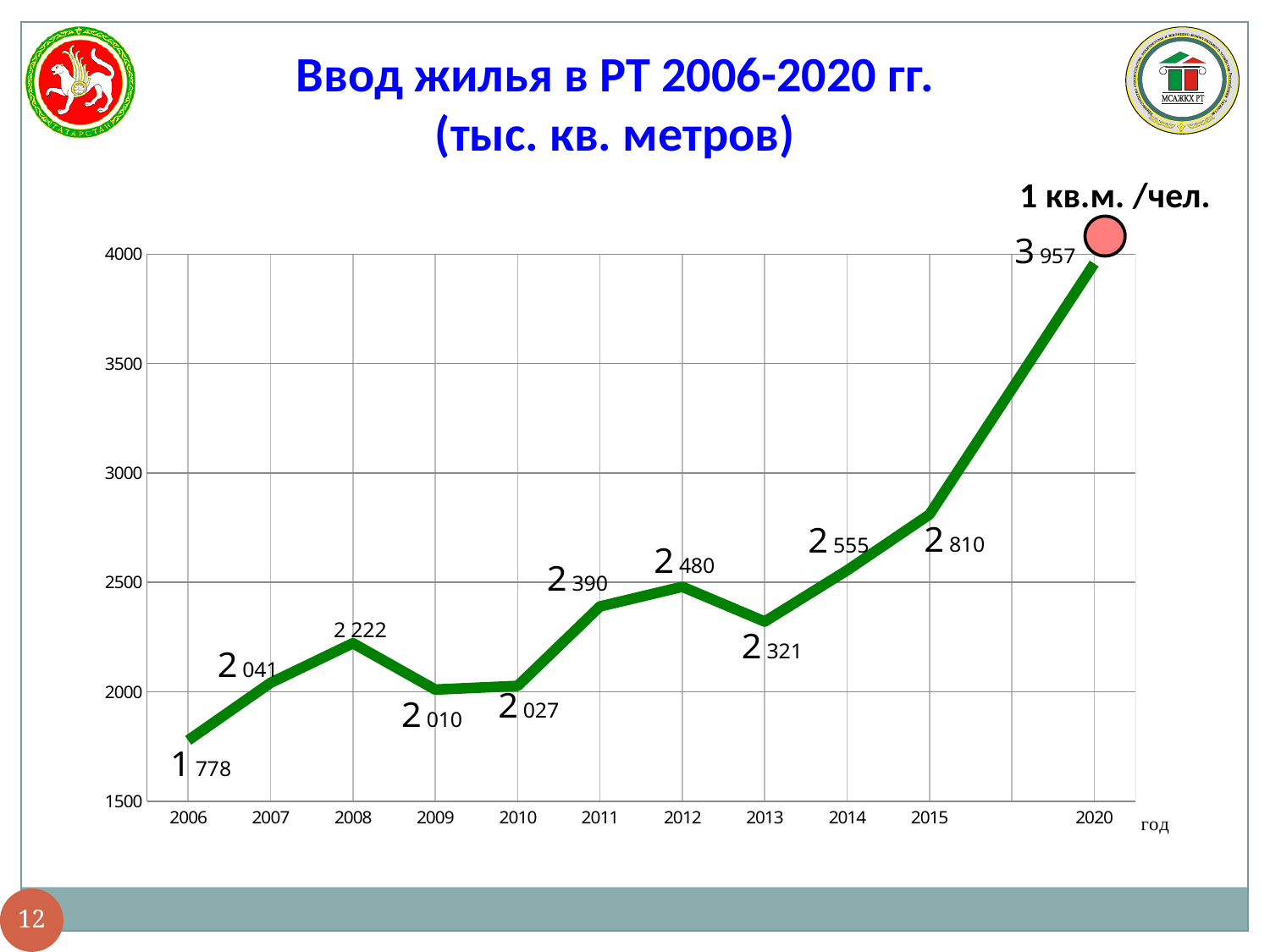
What is the value for 2013? 2 321 What is the difference between the values for 2015 and 2014? 255 Which year has the highest value? 2020 Is the value for 2015 greater or less than 3000? less Which is larger, the value for 2008 or the value for 2010? 2008 What is the value for 2020? 3 957 What is the value for 2006? 1 778 Which year has the lowest value? 2006 What type of chart is shown on the slide? line chart What is the title of the chart? Ввод жилья в РТ 2006-2020 гг. (тыс. кв. метров) What is the value for 2009? 2 010